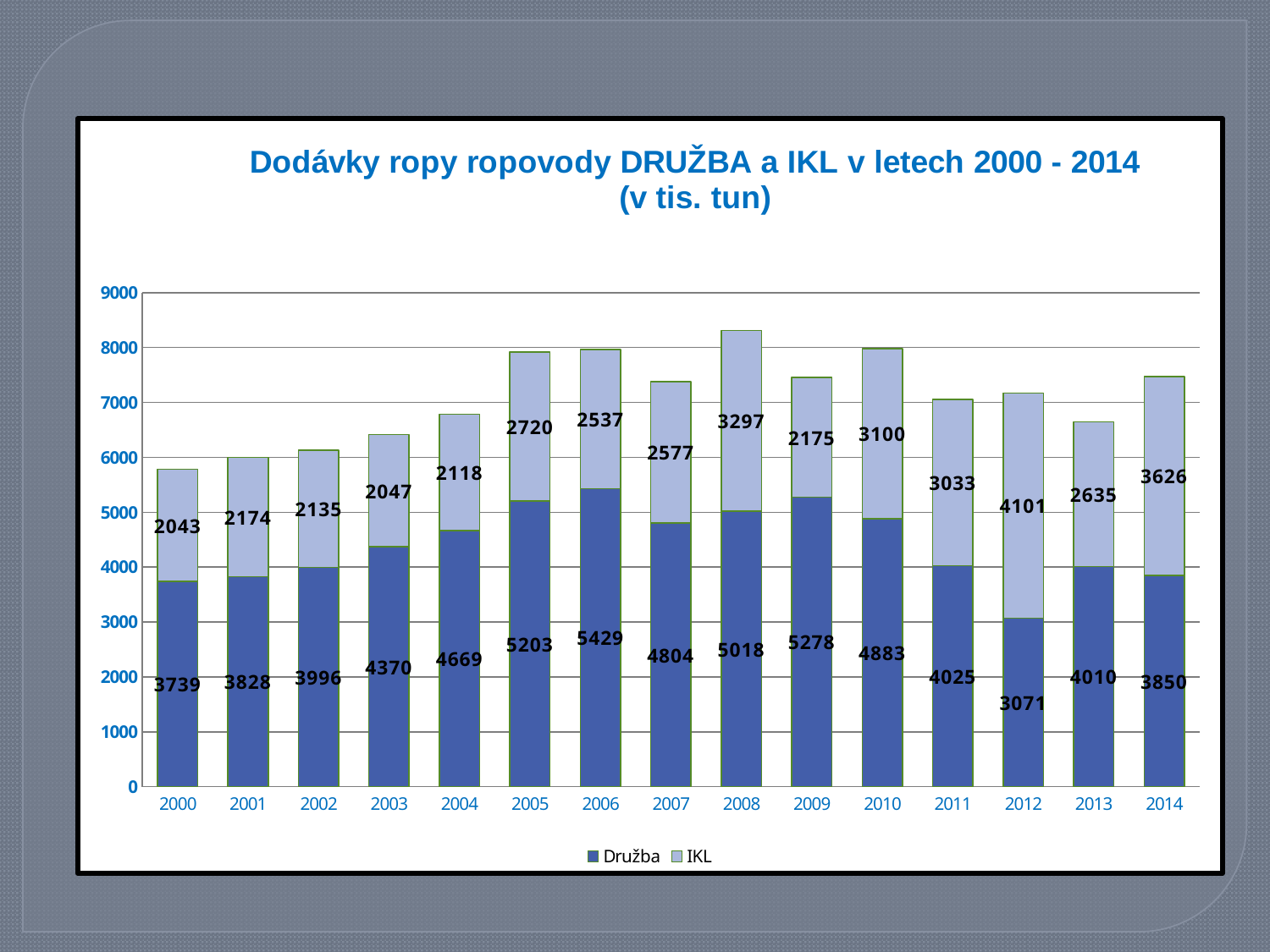
In 2012, which series has the larger value, Družba or IKL? IKL What is the total of the stacked bar for 2008? 8315 Which year has the highest Družba value? 2006 What kind of chart is shown on the slide? Stacked bar chart Which year has the lowest Družba value? 2012 Which year has the lowest IKL value? 2000 How many years are shown on the x axis? 15 What is the difference between the Družba and IKL values in 2006? 2892 What is the Družba value for 2000? 3739 What is the IKL value for 2012? 4101 What is the Družba value for 2006? 5429 How many series does the legend list? 2